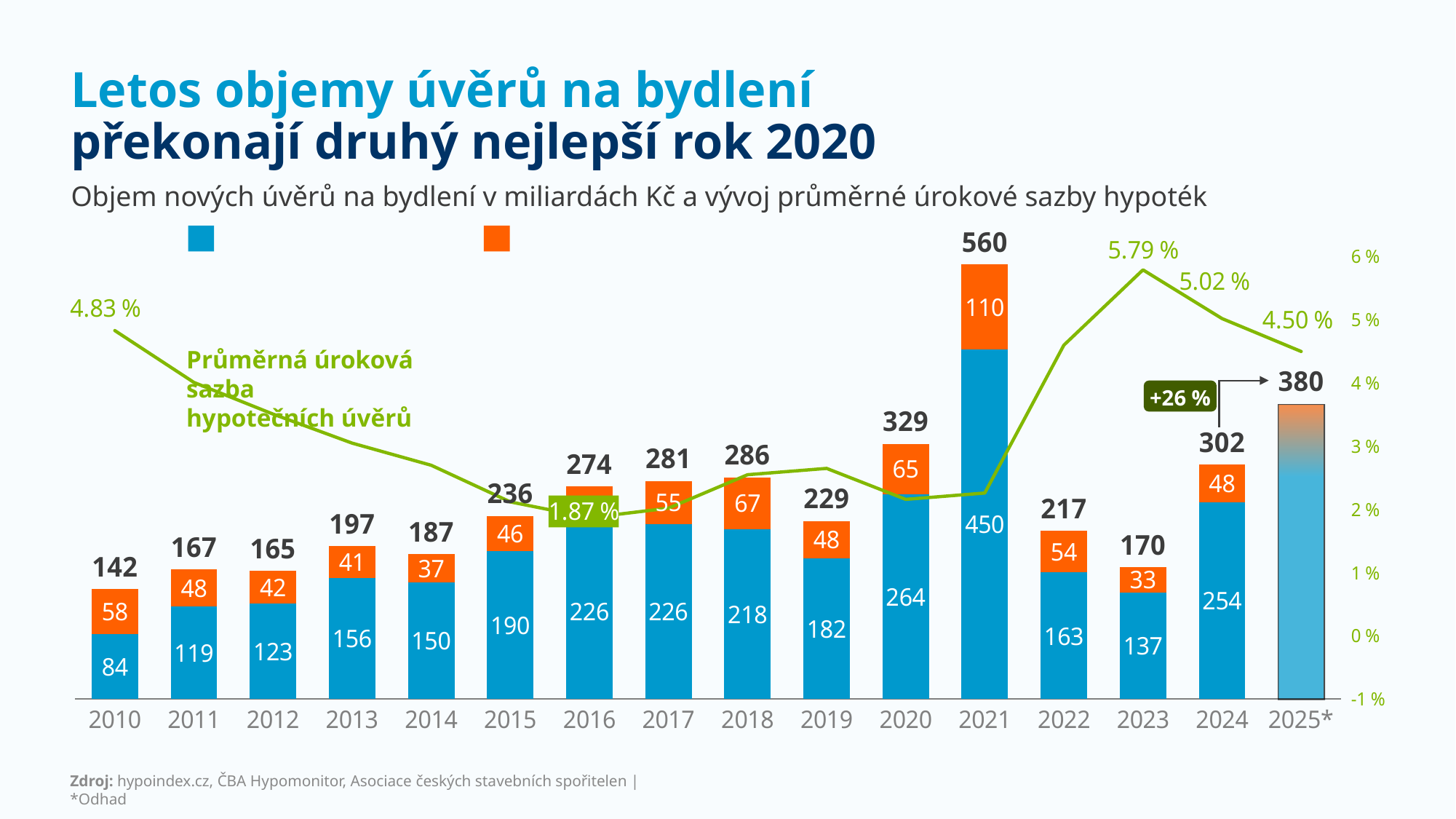
What is the value of the orange segment of the bar for 2018? 67 What percentage change is shown in the dark green box between 2024 and 2025*? +26 % What is the value of the blue segment of the bar for 2020? 264 What average mortgage interest rate is labelled for 2023? 5.79 % How many years are shown on the x axis? 16 What is the estimated total for 2025*? 380 Which year has the highest total bar? 2021 What is the total volume of new housing loans shown for 2021? 560 Which year has the lowest total bar? 2010 Which year has the larger total, 2017 or 2018? 2018 Is the average interest rate for 2020 greater or less than 3 %? less What is the difference between the total for 2021 and the total for 2020? 231